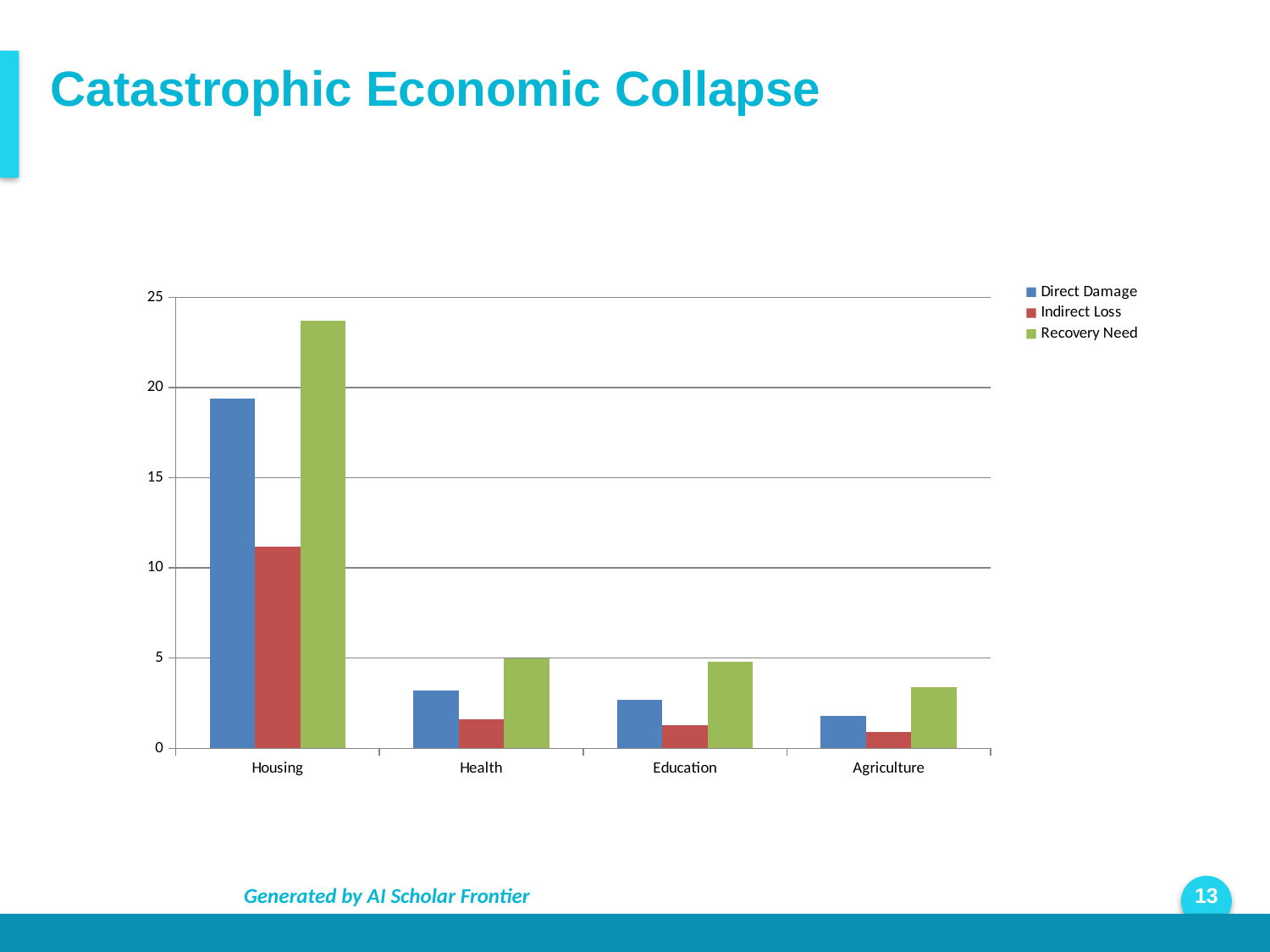
Which category has the highest Recovery Need value? Housing Which is larger for Health: Direct Damage or Indirect Loss? Direct Damage Which series is shown in green in the legend? Recovery Need Do the Direct Damage values rise or fall from Housing to Agriculture along the x axis? fall How many categories are shown on the x axis? 4 Is the Recovery Need value for Housing greater or less than 20? greater How many series does the legend list? 3 What kind of chart is shown on the slide? bar chart Which category has the lowest Direct Damage value? Agriculture Which category has the lowest Indirect Loss value? Agriculture Is the Indirect Loss value for Housing greater or less than 10? greater Is the Direct Damage value for Housing greater or less than 20? less